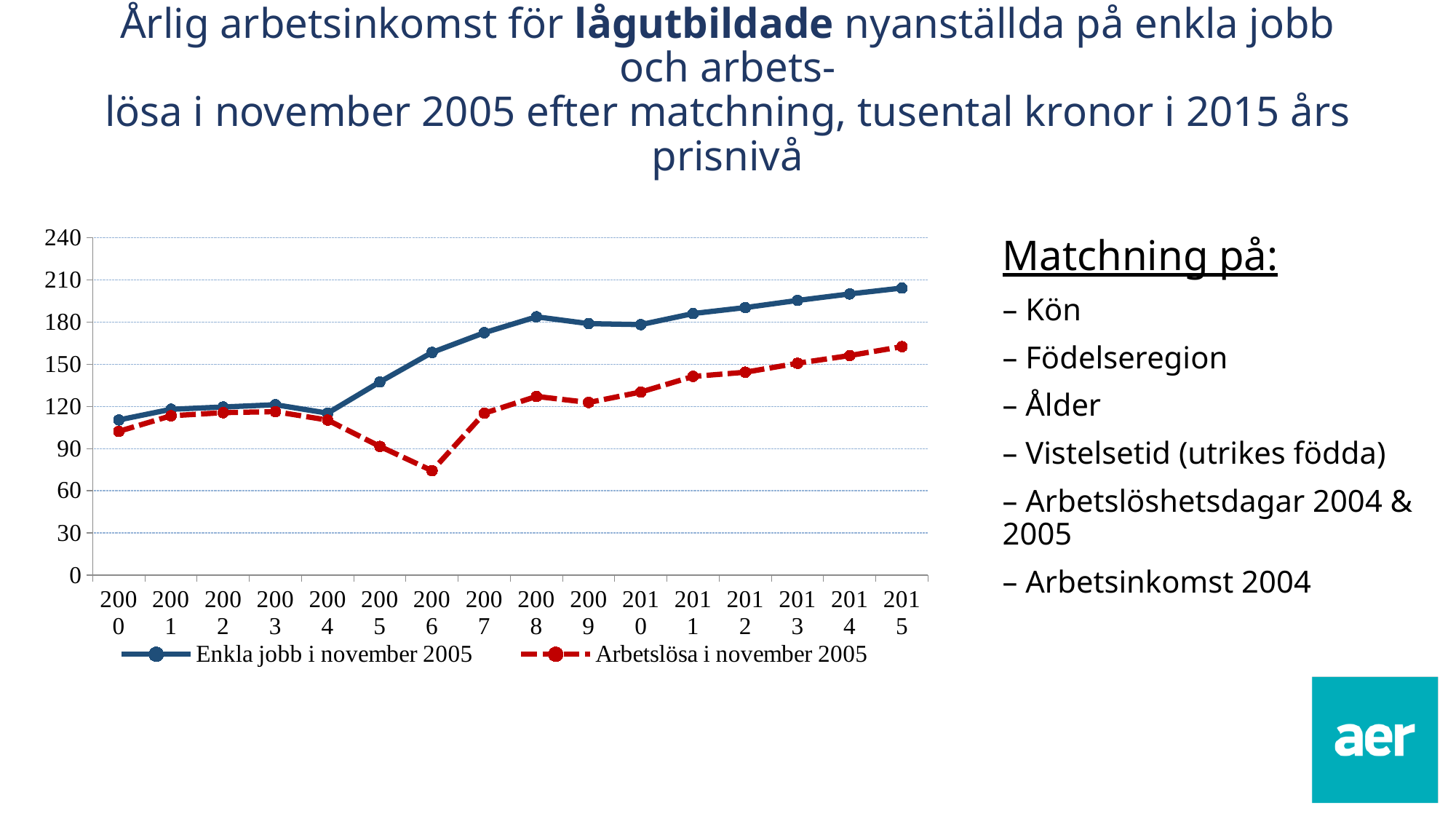
Which series is drawn with a red dashed line? Arbetslösa i november 2005 In which year is the Arbetslösa i november 2005 series at its lowest? 2006 Does the Arbetslösa i november 2005 series rise or fall from 2006 to 2015? rise What kind of chart is shown on the slide? line chart Is the value for Enkla jobb i november 2005 in 2000 greater or less than 120? less Is the value for Arbetslösa i november 2005 in 2015 greater or less than 150? greater Is the value for Arbetslösa i november 2005 in 2006 greater or less than 90? less How many years are plotted along the x axis? 16 How many series does the legend list? 2 In 2015, which series has the higher value: Enkla jobb i november 2005 or Arbetslösa i november 2005? Enkla jobb i november 2005 In which year is the Enkla jobb i november 2005 series at its highest? 2015